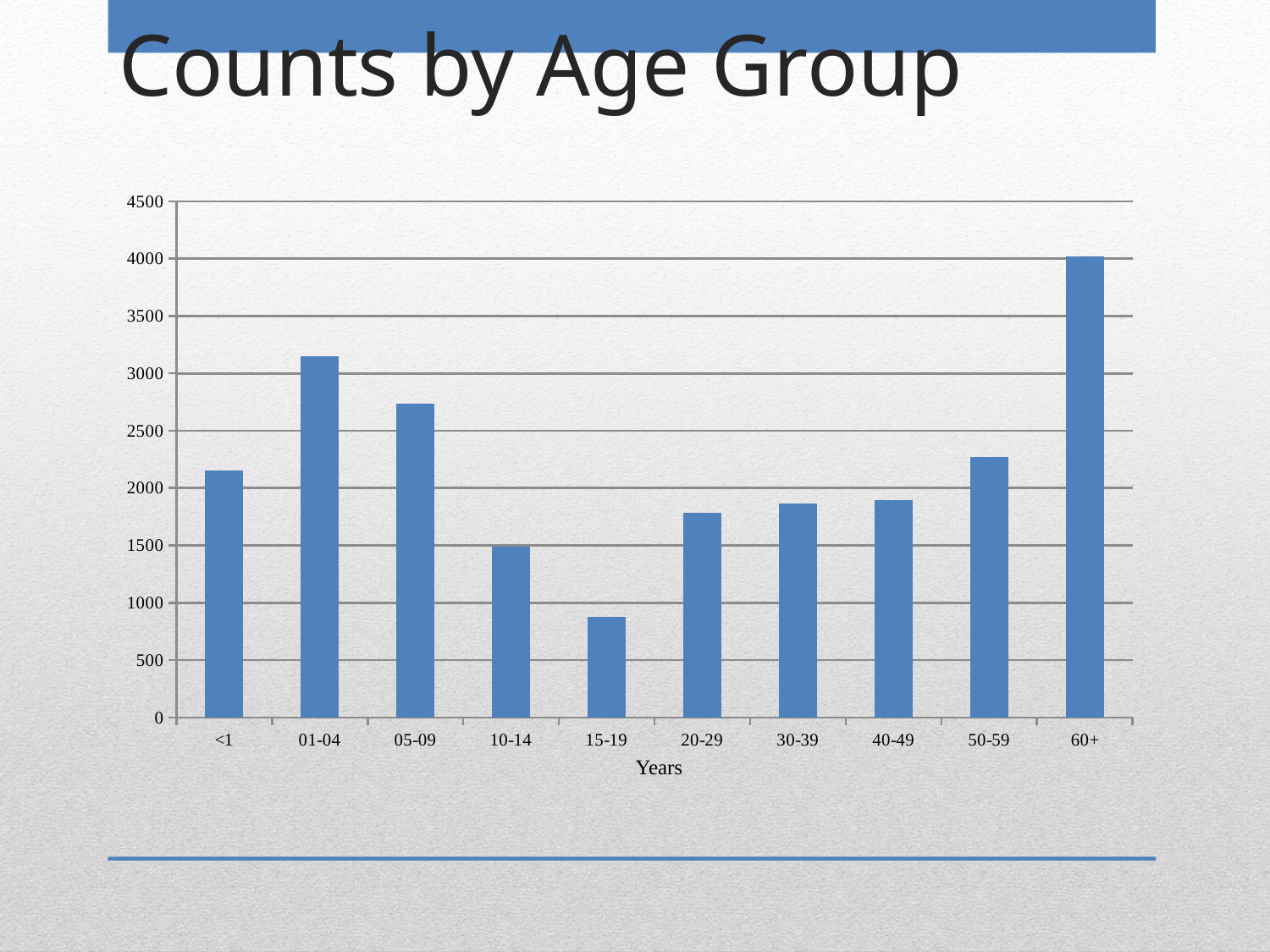
Is the value for the 01-04 age group greater or less than 3000? greater Is the value for the 05-09 age group greater or less than 2500? greater Is the value for the 60+ age group greater or less than 3500? greater Which has a larger count, the 10-14 age group or the 15-19 age group? 10-14 What is the label on the x axis of the chart? Years Which has a larger count, the 01-04 age group or the 05-09 age group? 01-04 How many age groups are shown on the x axis? 10 Which age group has the highest count? 60+ What kind of chart is shown on the slide? bar chart Which age group has the lowest count? 15-19